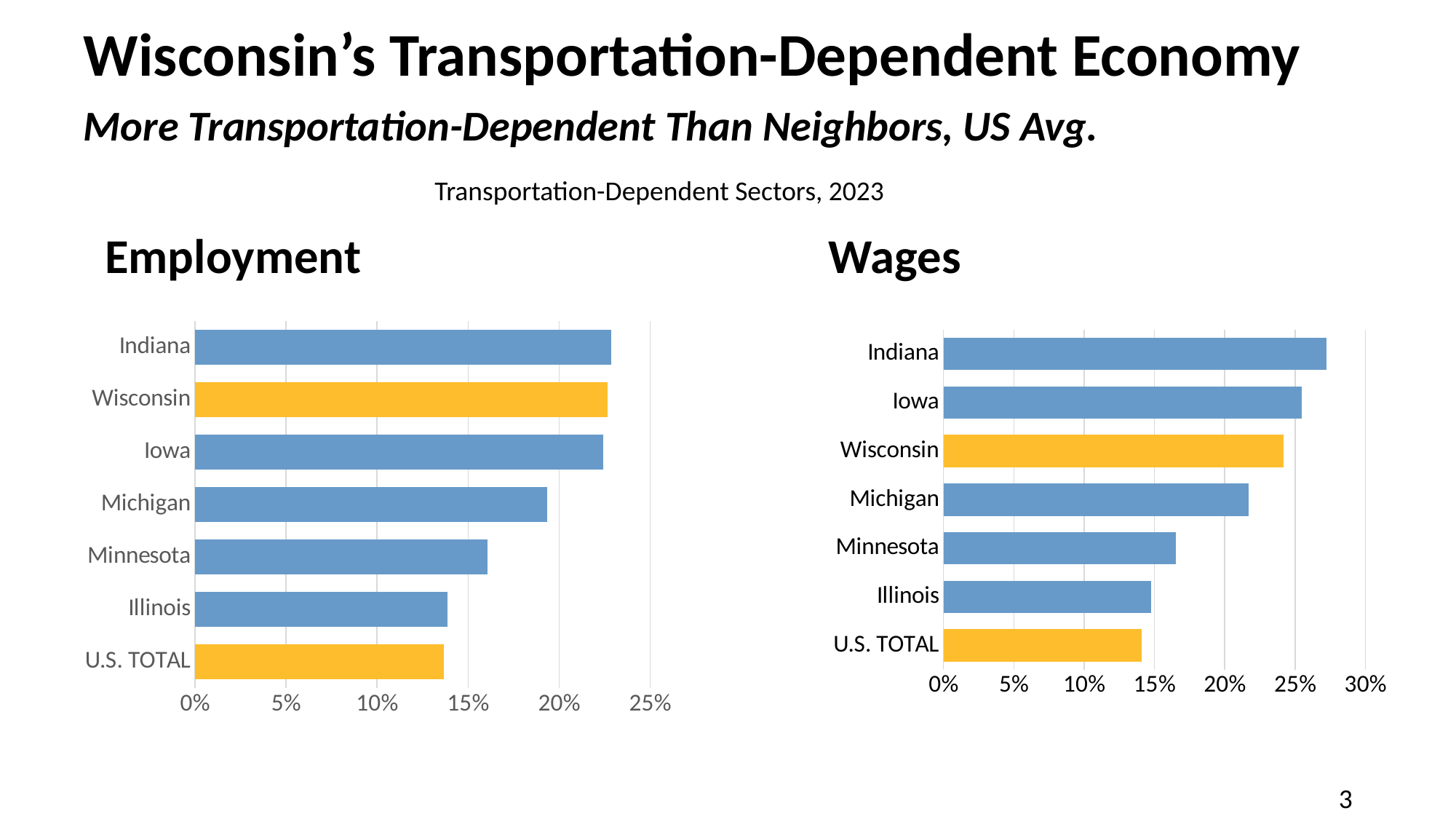
In the Employment chart, is the value for Wisconsin greater or less than 20%? greater In the Employment chart, which categories are shown with yellow bars? Wisconsin and U.S. TOTAL In the Wages chart, which is larger, the value for Wisconsin or the value for Michigan? Wisconsin In the Wages chart, which category has the highest value? Indiana In the Wages chart, which is larger, the value for Iowa or the value for Wisconsin? Iowa In the Wages chart, is the value for Indiana greater or less than 25%? greater In the Employment chart, which is larger, the value for Minnesota or the value for Illinois? Minnesota How many categories are shown in the Wages chart? 7 In the Wages chart, is the value for Minnesota greater or less than 20%? less What kind of chart is the Employment chart? bar chart What is the highest tick value on the x axis of the Wages chart? 30%